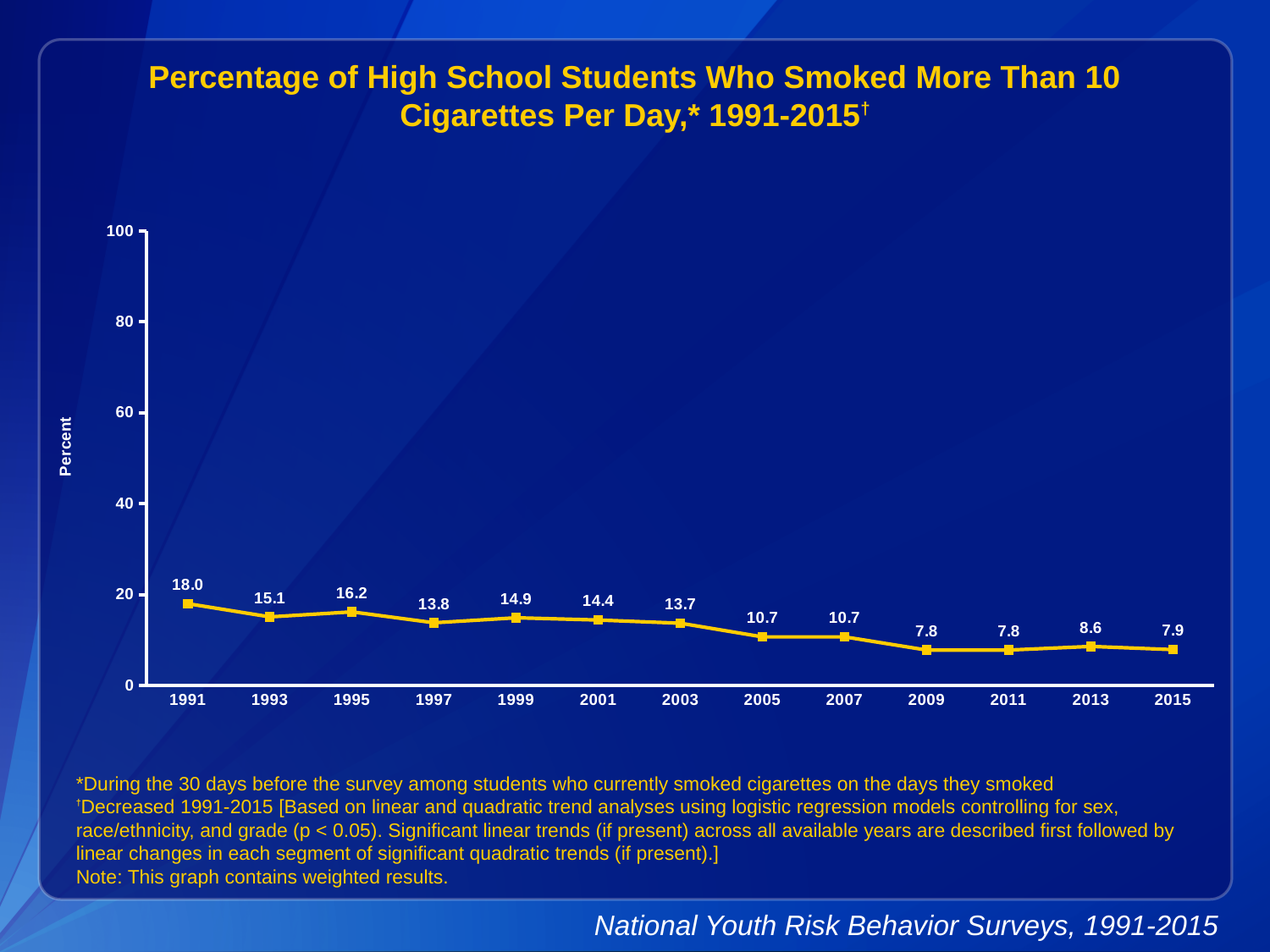
What is the difference between the values for 1991 and 2015? 10.1 What was the percentage of high school students who smoked more than 10 cigarettes per day in 1991? 18.0 What value is shown for 2005? 10.7 Which year has the highest value on the chart? 1991 What is the lowest value plotted on the chart? 7.8 Do the values generally rise or fall from 1991 to 2015? fall Which year has the larger value, 1995 or 1997? 1995 How many years are plotted on the x axis? 13 Is the value for 2003 greater or less than 20? less What value is shown for 2015? 7.9 What kind of chart is shown on the slide? line chart What is the label on the y axis? Percent